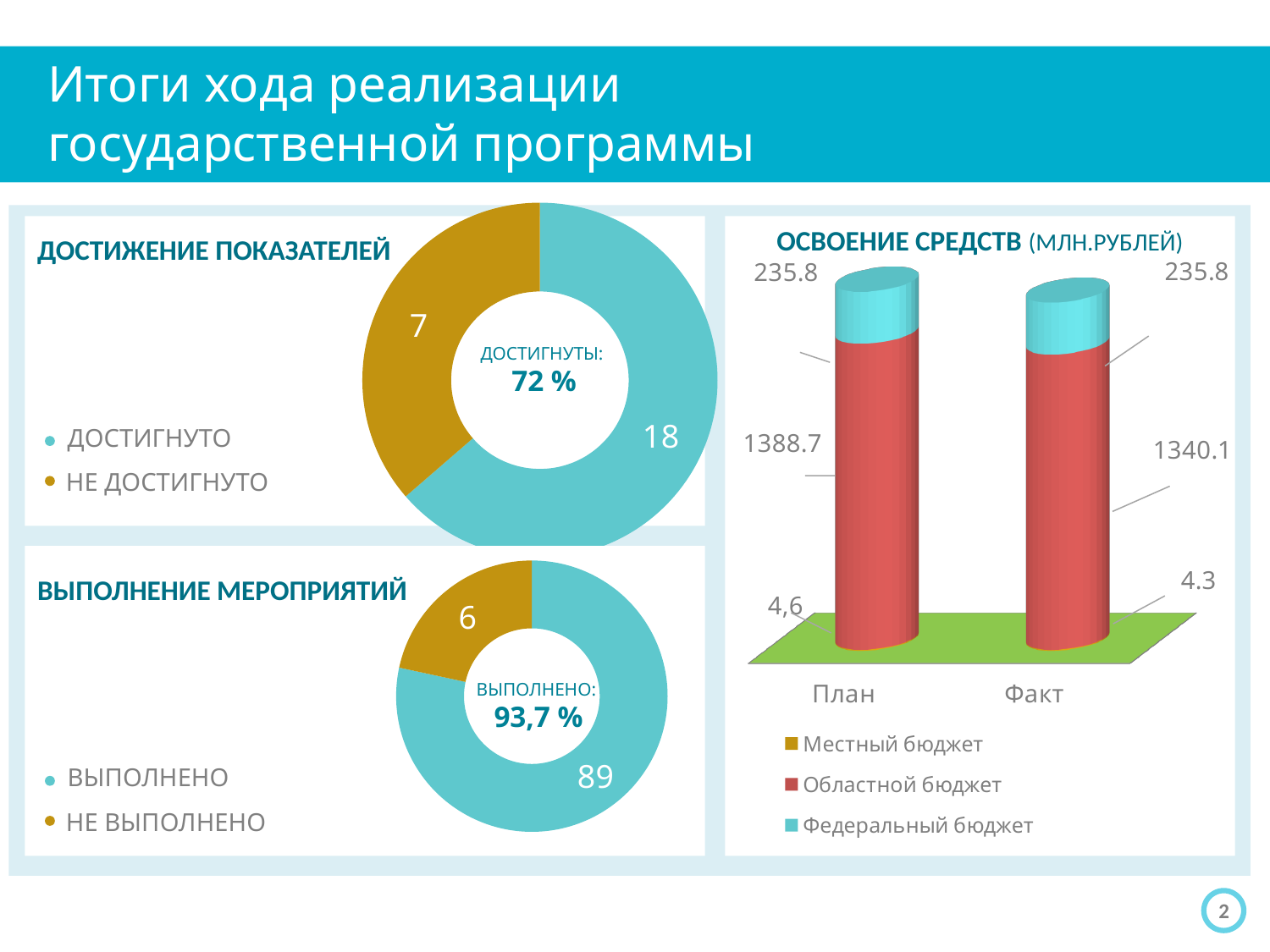
In the ДОСТИЖЕНИЕ ПОКАЗАТЕЛЕЙ chart, how many indicators are marked НЕ ДОСТИГНУТО? 7 In the ВЫПОЛНЕНИЕ МЕРОПРИЯТИЙ chart, how many activities are marked ВЫПОЛНЕНО? 89 In the ОСВОЕНИЕ СРЕДСТВ chart, what is the Областной бюджет value for Факт? 1340.1 In the ДОСТИЖЕНИЕ ПОКАЗАТЕЛЕЙ chart, how many indicators are marked ДОСТИГНУТО? 18 In the ВЫПОЛНЕНИЕ МЕРОПРИЯТИЙ chart, what percentage is shown in the centre as ВЫПОЛНЕНО? 93,7 % In the ОСВОЕНИЕ СРЕДСТВ chart, what is the total of the Факт bar? 1580.2 In the ОСВОЕНИЕ СРЕДСТВ chart, how many series does the legend list? 3 In the ВЫПОЛНЕНИЕ МЕРОПРИЯТИЙ chart, what is the difference between ВЫПОЛНЕНО and НЕ ВЫПОЛНЕНО? 83 In the ОСВОЕНИЕ СРЕДСТВ chart, what is the difference between the Областной бюджет values for План and Факт? 48.6 In the ОСВОЕНИЕ СРЕДСТВ chart, what is the Областной бюджет value for План? 1388.7 In the ДОСТИЖЕНИЕ ПОКАЗАТЕЛЕЙ chart, what percentage is shown in the centre as ДОСТИГНУТЫ? 72 % What kind of chart is the ВЫПОЛНЕНИЕ МЕРОПРИЯТИЙ chart? Donut (pie) chart